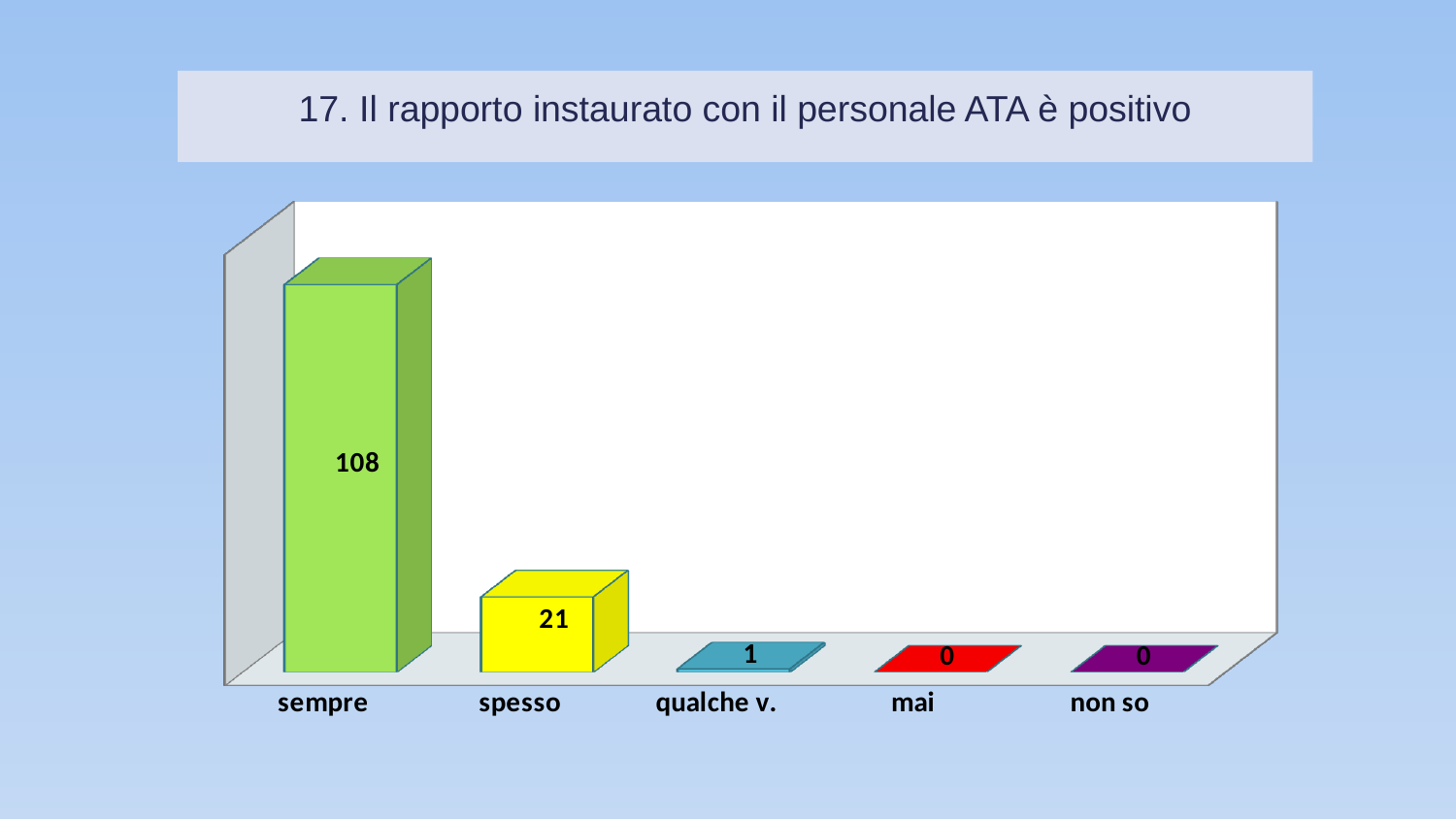
What is the value for "sempre"? 108 What kind of chart is shown on the slide? bar chart Which is larger, the value for "spesso" or the value for "qualche v."? spesso How many categories are shown on the x axis? 5 What is the value for "mai"? 0 Which category has the highest value? sempre What is the difference between the values for "sempre" and "spesso"? 87 What is the value for "spesso"? 21 What colour is the bar for "spesso"? yellow What is the value for "qualche v."? 1 Do the values rise or fall from left to right along the x axis? fall What is the title of the slide above the chart? 17. Il rapporto instaurato con il personale ATA è positivo